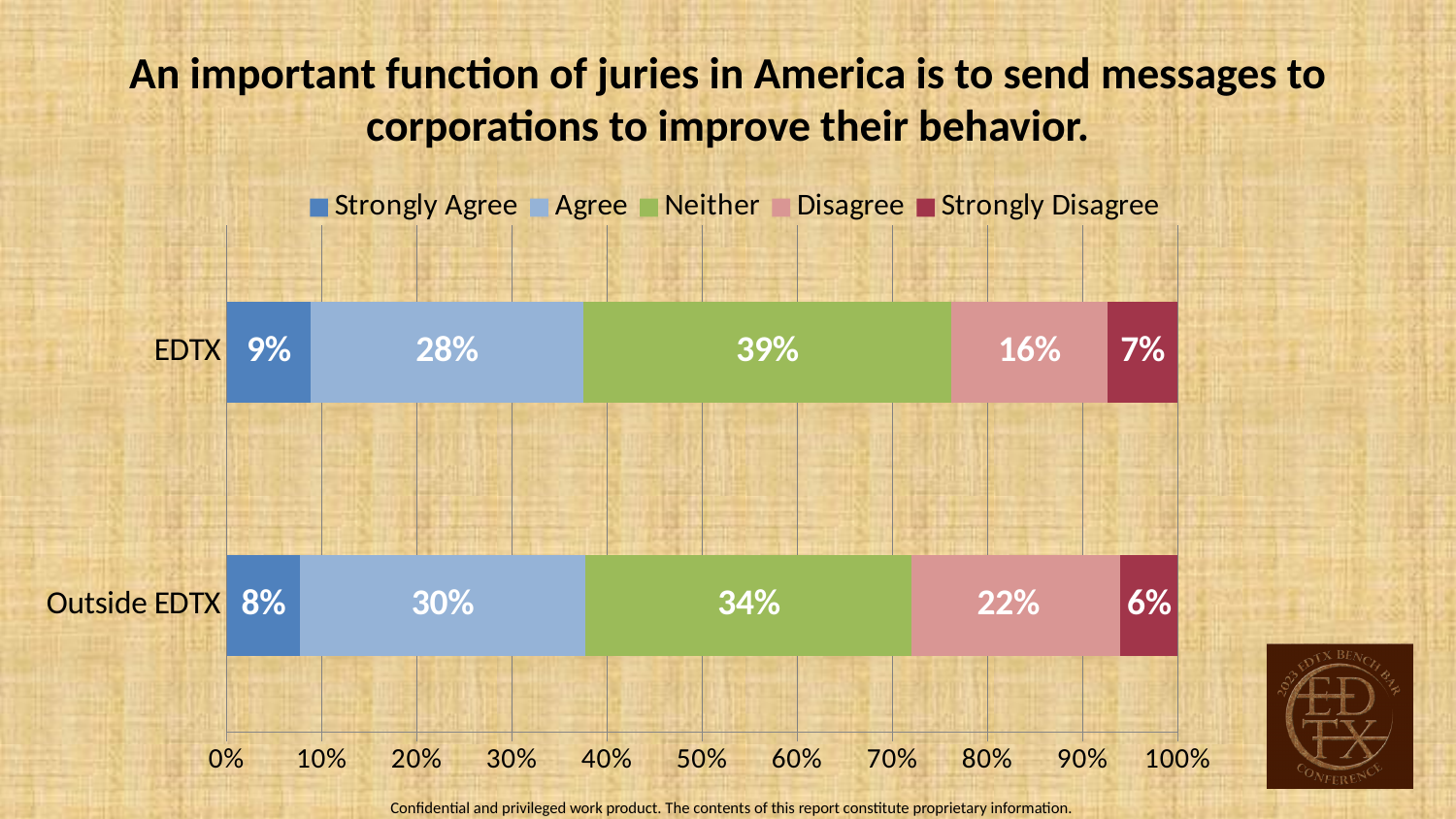
What kind of chart is shown on the slide? Stacked bar chart Which response category has the smallest share for EDTX? Strongly Disagree What percentage of EDTX respondents answered Strongly Agree? 9% What percentage of Outside EDTX respondents answered Agree? 30% How many groups (bars) are shown in the chart? 2 What is the combined percentage of Strongly Agree and Agree for EDTX? 37% Which response category has the largest share for Outside EDTX? Neither What is the difference between the Disagree percentages for Outside EDTX and EDTX? 6% What percentage of Outside EDTX respondents answered Disagree? 22% How many series does the legend list? 5 What percentage of EDTX respondents answered Neither? 39% Which group has a higher Neither percentage, EDTX or Outside EDTX? EDTX